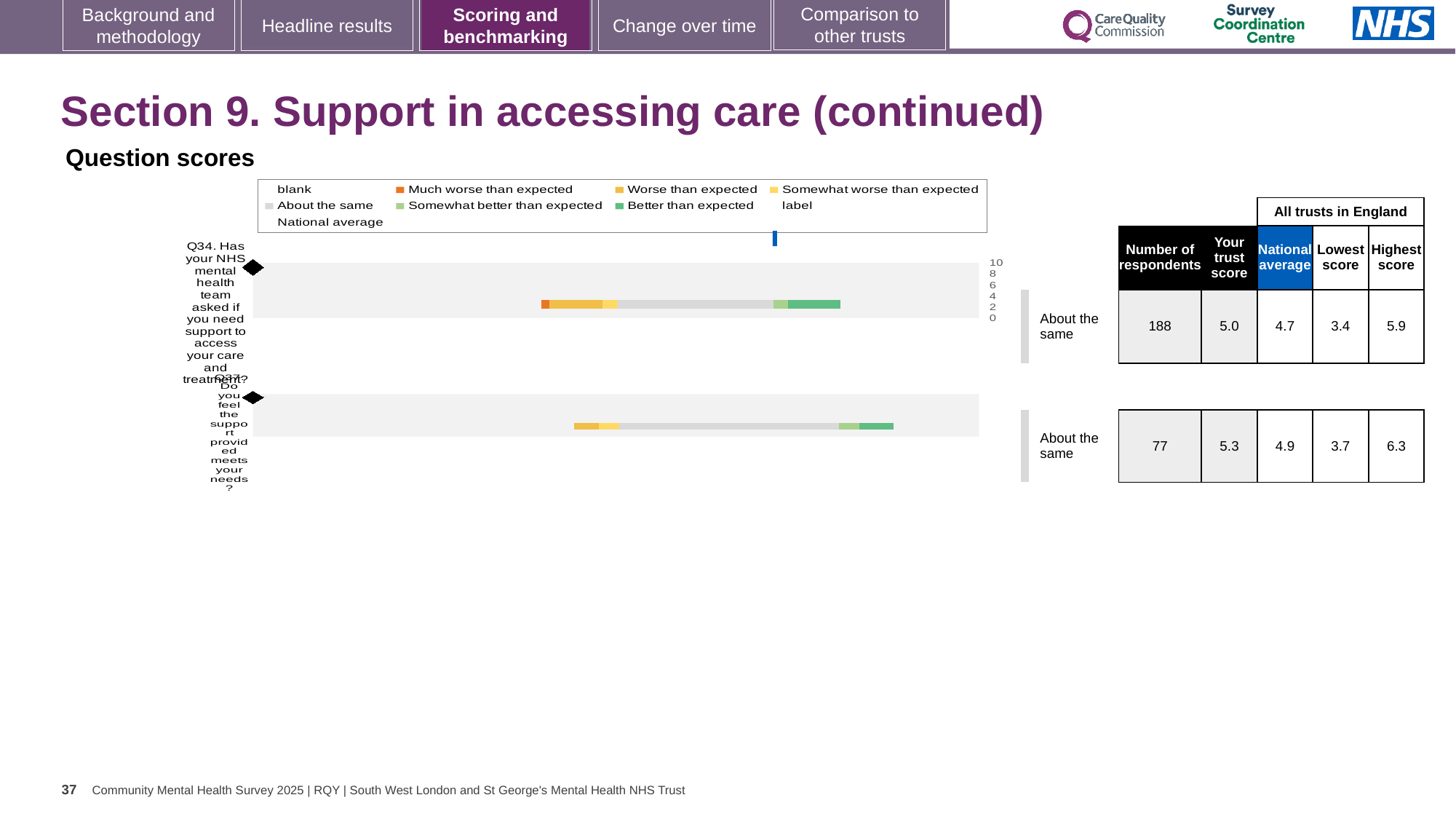
How many more respondents answered Q34 than Q37? 111 What is the highest score among all trusts in England for Q34? 5.9 What kind of chart is used to show the question scores on this slide? Stacked horizontal bar chart What benchmark category is shown for Q37's trust score? About the same What is the trust score for Q34 (Has your NHS mental health team asked if you need support to access your care and treatment)? 5.0 What is the lowest score among all trusts in England for Q37? 3.7 What is the difference between the trust score and the national average for Q34? 0.3 What is the national average score for Q37? 4.9 How many survey questions are plotted in the question scores chart? 2 Which question has the higher trust score, Q34 or Q37? Q37 What is the trust score for Q37 (Do you feel the support provided meets your needs)? 5.3 How many respondents answered Q34? 188